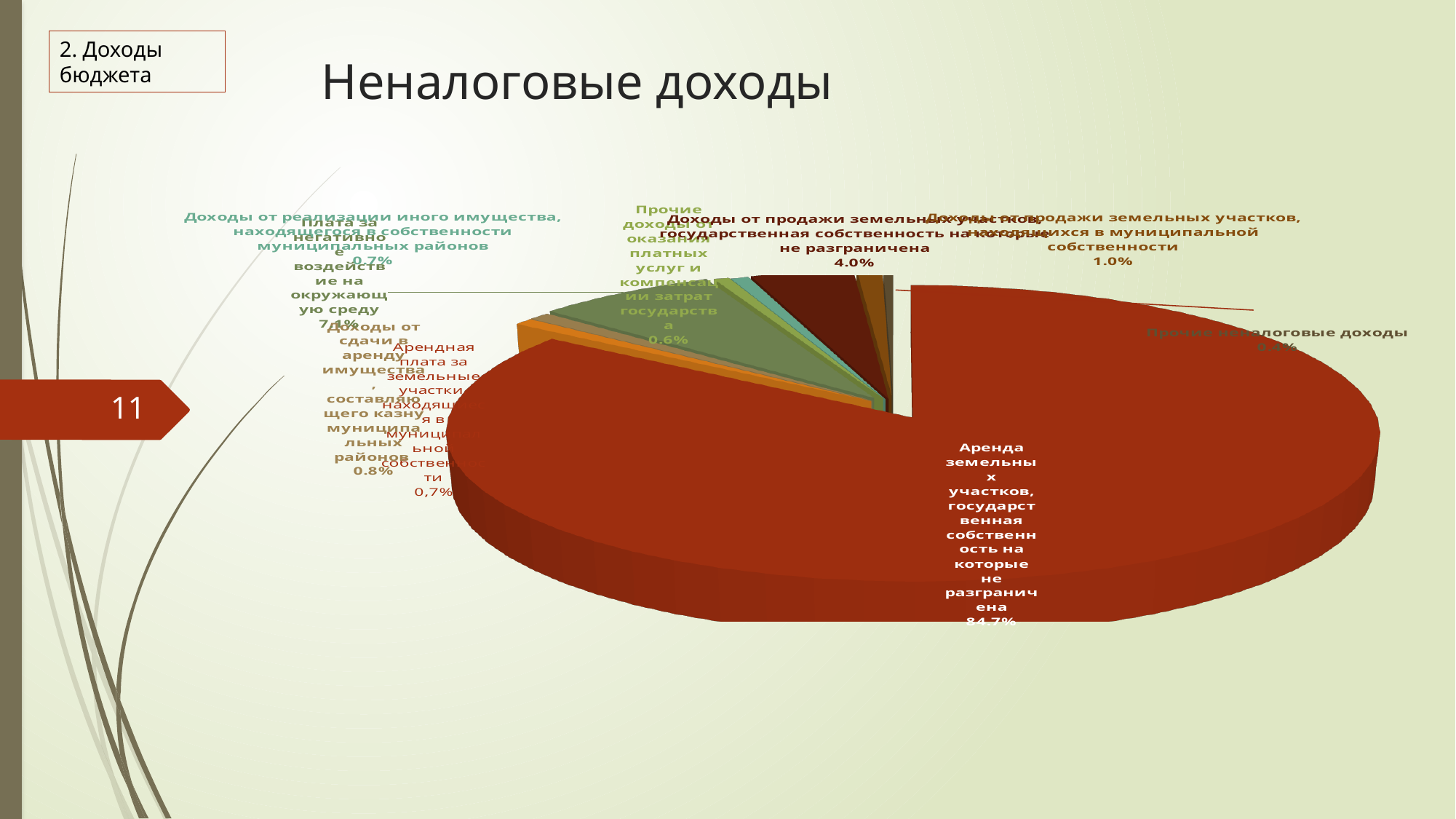
Which is larger: the share for 'Доходы от продажи земельных участков, государственная собственность на которые не разграничена' or the share for 'Доходы от продажи земельных участков, находящихся в муниципальной собственности'? Доходы от продажи земельных участков, государственная собственность на которые не разграничена Which category has the largest share of the pie? Аренда земельных участков, государственная собственность на которые не разграничена What share is shown for 'Доходы от продажи земельных участков, находящихся в муниципальной собственности'? 1.0% What share of the pie is labelled for 'Аренда земельных участков, государственная собственность на которые не разграничена'? 84.7% Which category has the smallest share of the pie? Прочие неналоговые доходы What share is shown for 'Доходы от продажи земельных участков, государственная собственность на которые не разграничена'? 4.0% What share is shown for 'Доходы от сдачи в аренду имущества, составляющего казну муниципальных районов'? 0.8% What kind of chart is shown on the slide? pie chart What share is shown for 'Доходы от реализации иного имущества, находящегося в собственности муниципальных районов'? 0.7% What share is shown for 'Прочие неналоговые доходы'? 0.4% By how many percentage points does the share for 'Аренда земельных участков, государственная собственность на которые не разграничена' exceed the share for 'Доходы от продажи земельных участков, государственная собственность на которые не разграничена'? 80.7 What is the title of the chart on the slide? Неналоговые доходы